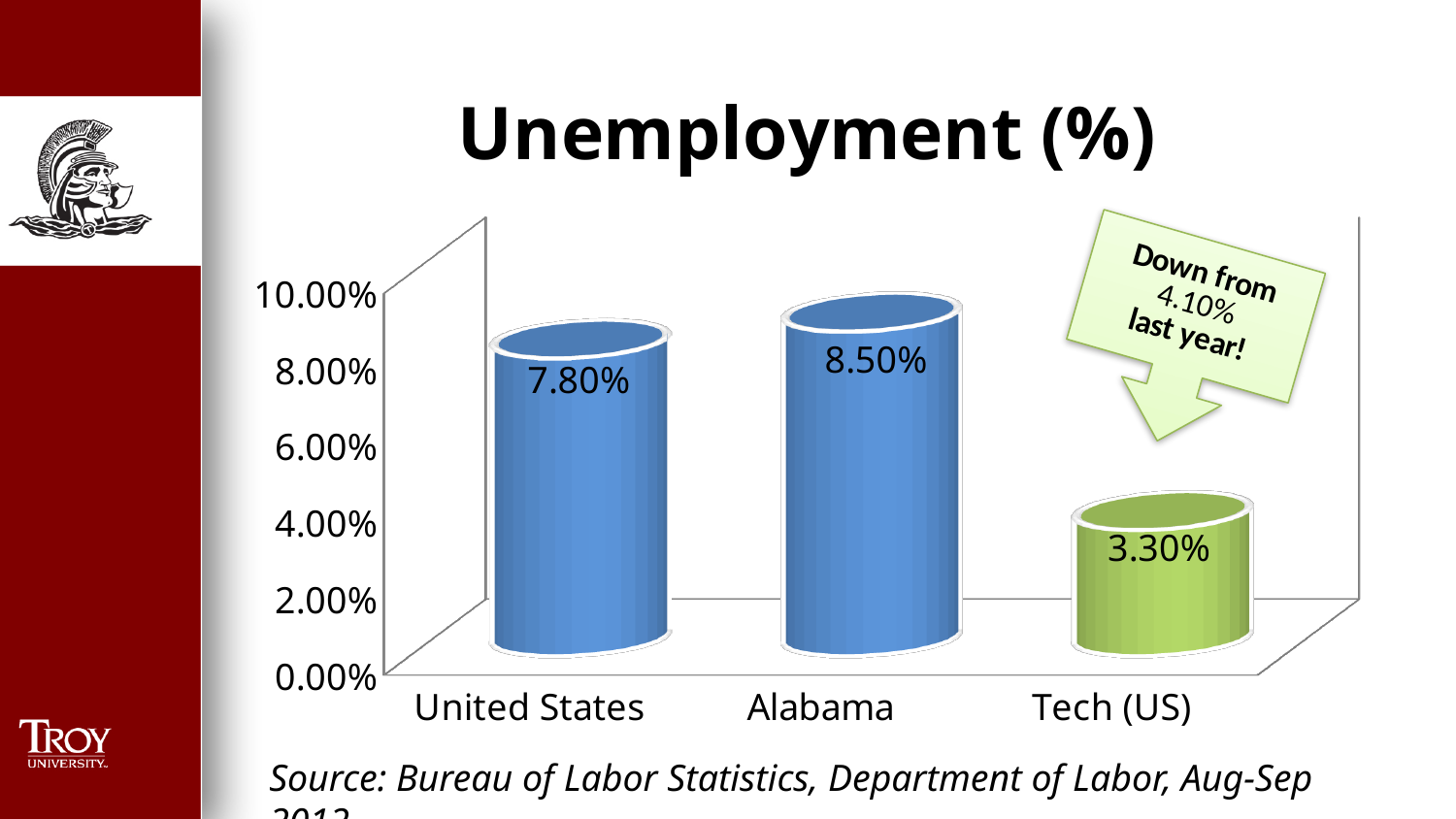
Which category has the lowest unemployment rate? Tech (US) What is the unemployment rate shown for the United States? 7.80% What is the unemployment rate shown for Alabama? 8.50% What is the unemployment rate shown for Tech (US)? 3.30% How many categories are shown on the chart? 3 According to the callout, what was the Tech (US) unemployment rate last year? 4.10% What is the difference between the unemployment rates for Alabama and the United States? 0.70% Which has a higher unemployment rate, Alabama or Tech (US)? Alabama Which category has the highest unemployment rate? Alabama What kind of chart is shown on the slide? Bar chart Is the value for Tech (US) greater or less than 4.00%? less What is the difference between the unemployment rates for the United States and Tech (US)? 4.50%